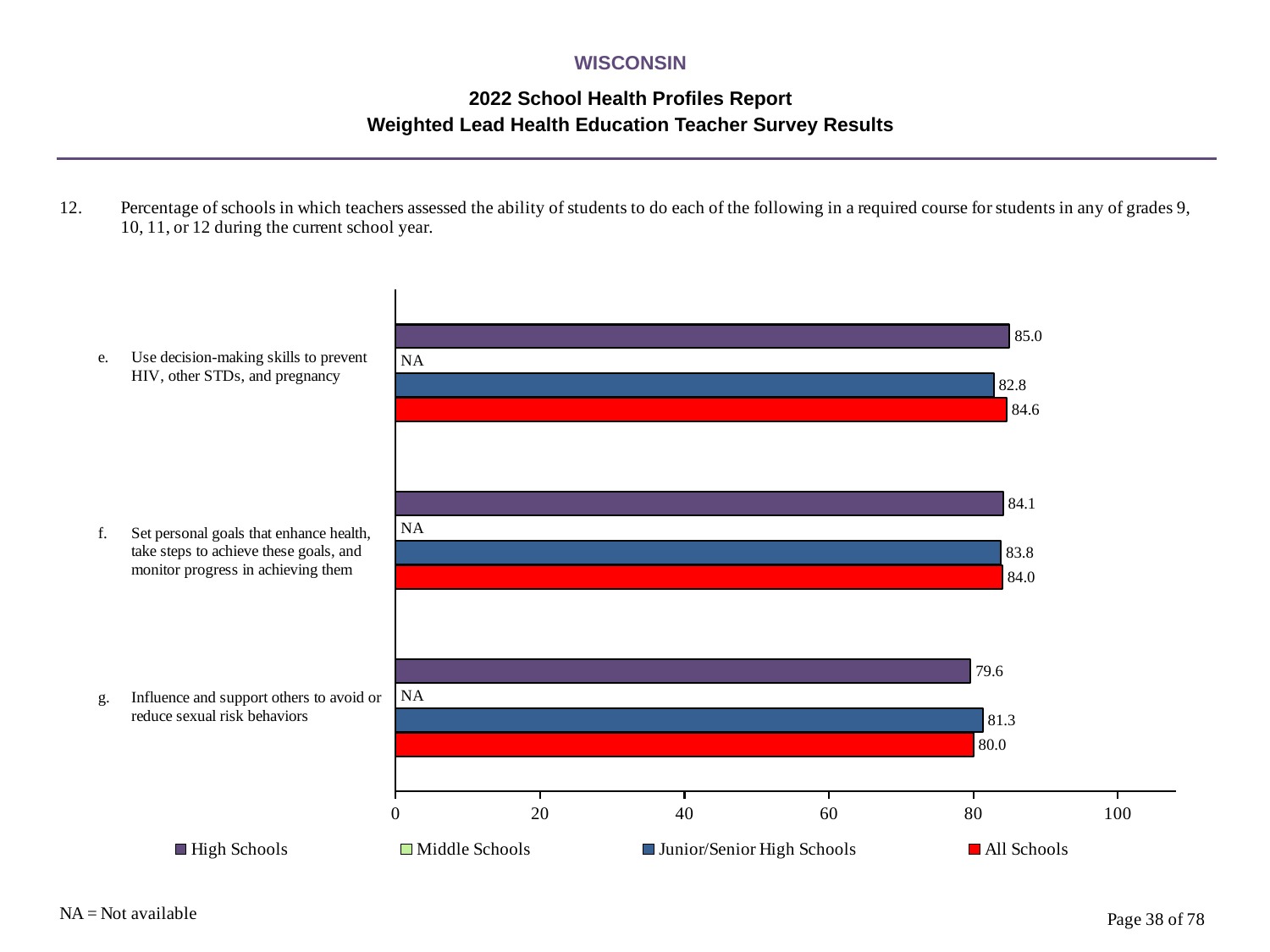
What is the difference between the High Schools value and the Junior/Senior High Schools value for item e? 2.2 What colour are the All Schools bars? red What is the All Schools value for item f, 'Set personal goals that enhance health, take steps to achieve these goals, and monitor progress in achieving them'? 84.0 What is the value for Junior/Senior High Schools for item g, 'Influence and support others to avoid or reduce sexual risk behaviors'? 81.3 Which item has the highest All Schools value? e. Use decision-making skills to prevent HIV, other STDs, and pregnancy Is the All Schools value for item g greater or less than 60? greater What is the value for High Schools for item e, 'Use decision-making skills to prevent HIV, other STDs, and pregnancy'? 85.0 How many series does the legend list? 4 What is shown for Middle Schools for item e? NA What kind of chart is shown on the slide? bar chart For item g, which is larger: the High Schools value or the Junior/Senior High Schools value? Junior/Senior High Schools Which item has the lowest High Schools value? g. Influence and support others to avoid or reduce sexual risk behaviors